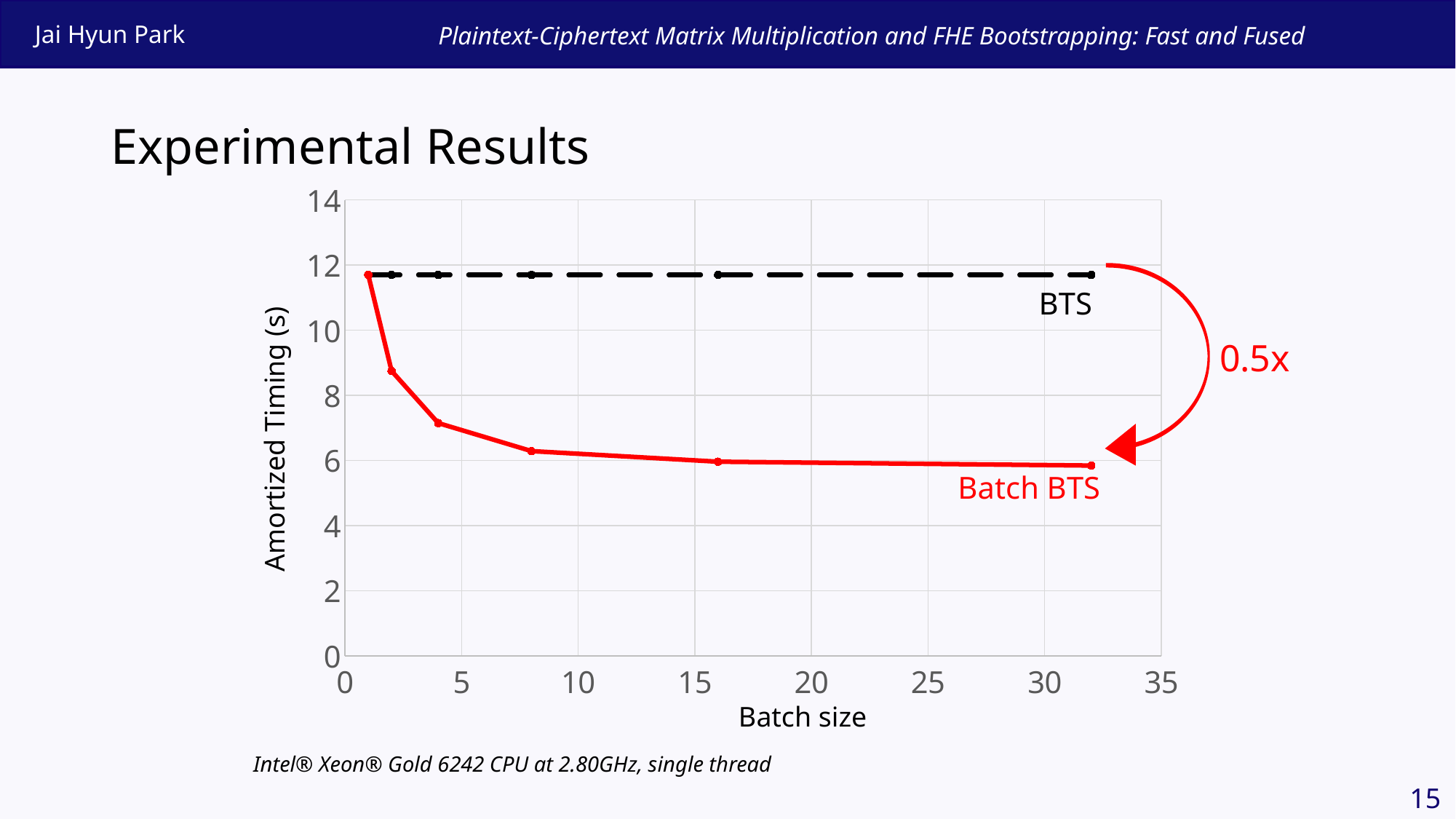
Is the amortized timing for Batch BTS at batch size 2 greater or less than 8 seconds? greater Does the Batch BTS line rise or fall as batch size increases? fall Is the amortized timing for BTS greater or less than 10 seconds? greater How many series are plotted in the chart? 2 What kind of chart is shown on the slide? line chart At batch size 16, which series has the higher amortized timing, BTS or Batch BTS? BTS How many data points are plotted on the Batch BTS line? 6 Is the amortized timing for Batch BTS at batch size 32 greater or less than 8 seconds? less What is the label of the y axis? Amortized Timing (s) Does the BTS line rise, fall, or stay flat as batch size increases? stay flat What are the names of the two series plotted in the chart? BTS and Batch BTS